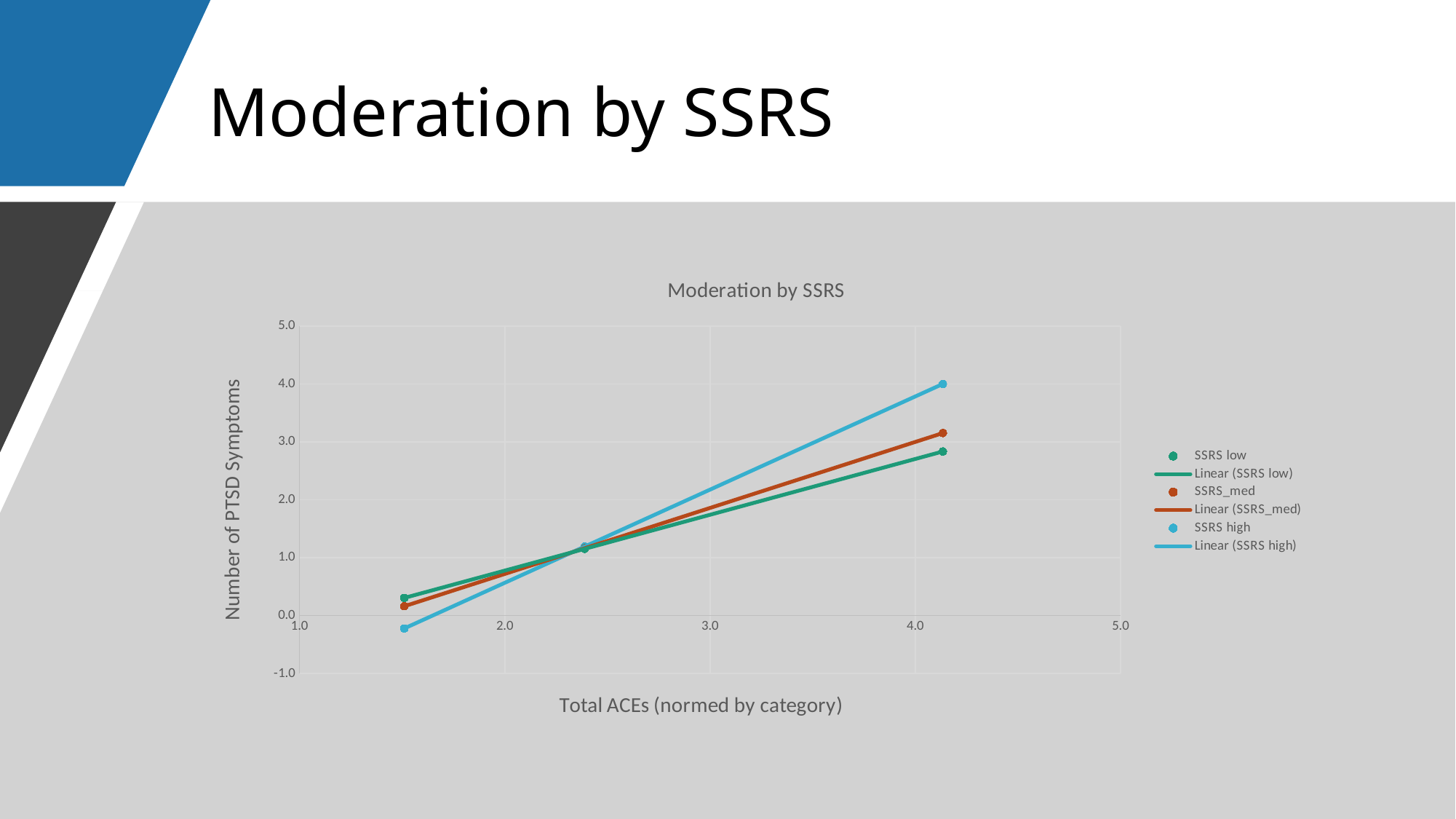
Is the value for SSRS low at the highest Total ACEs point greater or less than 3.0? less What kind of chart is shown on the slide? scatter chart How many entries does the legend list? 6 Is the value for SSRS high at the lowest Total ACEs point greater or less than 0.0? less Is the value for SSRS high at the highest Total ACEs point greater or less than 3.0? greater At the highest Total ACEs point, which series has the larger value, SSRS high or SSRS low? SSRS high What is the title of the chart? Moderation by SSRS What is the label of the vertical axis? Number of PTSD Symptoms How many data points are plotted for the SSRS high series? 3 Do the values for SSRS high rise or fall as Total ACEs increases? rise Which series has the highest value at the highest Total ACEs point? SSRS high